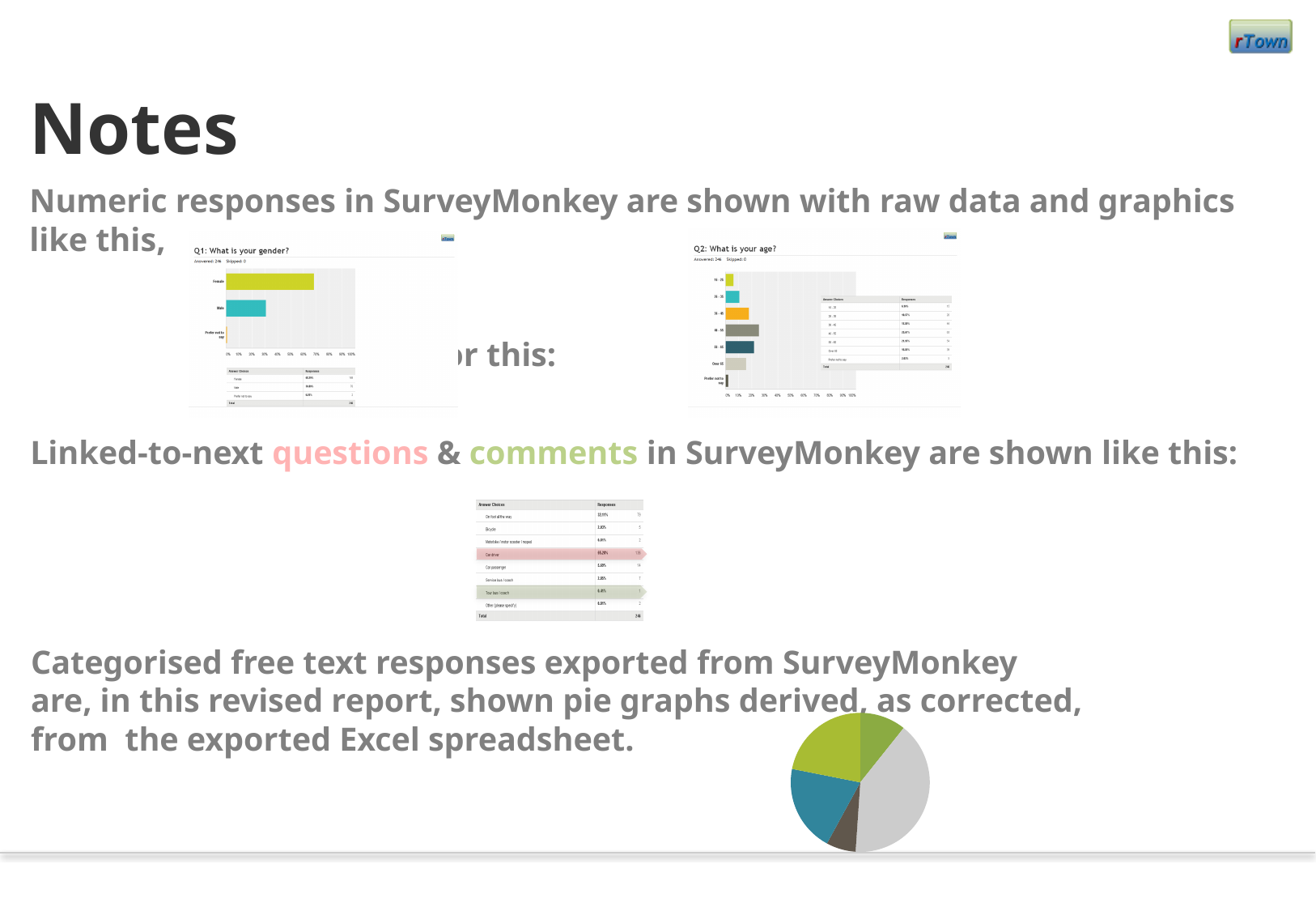
In the 'Q1: What is your gender?' chart, which is larger, Female or Male? Female In the 'Q2: What is your age?' chart, which category has the lowest value? Prefer not to say How many categories does the 'Q2: What is your age?' chart show? 7 What kind of chart is the 'Q1: What is your gender?' chart? bar chart In the 'Q1: What is your gender?' chart, is the value for Female greater or less than 50%? greater What kind of chart is the 'Q2: What is your age?' chart? bar chart How many categories does the 'Q1: What is your gender?' chart show? 3 In the 'Q1: What is your gender?' chart, which category has the highest value? Female In the 'Q1: What is your gender?' chart, is the value for Male greater or less than 50%? less In the 'Q1: What is your gender?' chart, which category has the lowest value? Prefer not to say What kind of chart is shown at the bottom right of the slide? pie chart